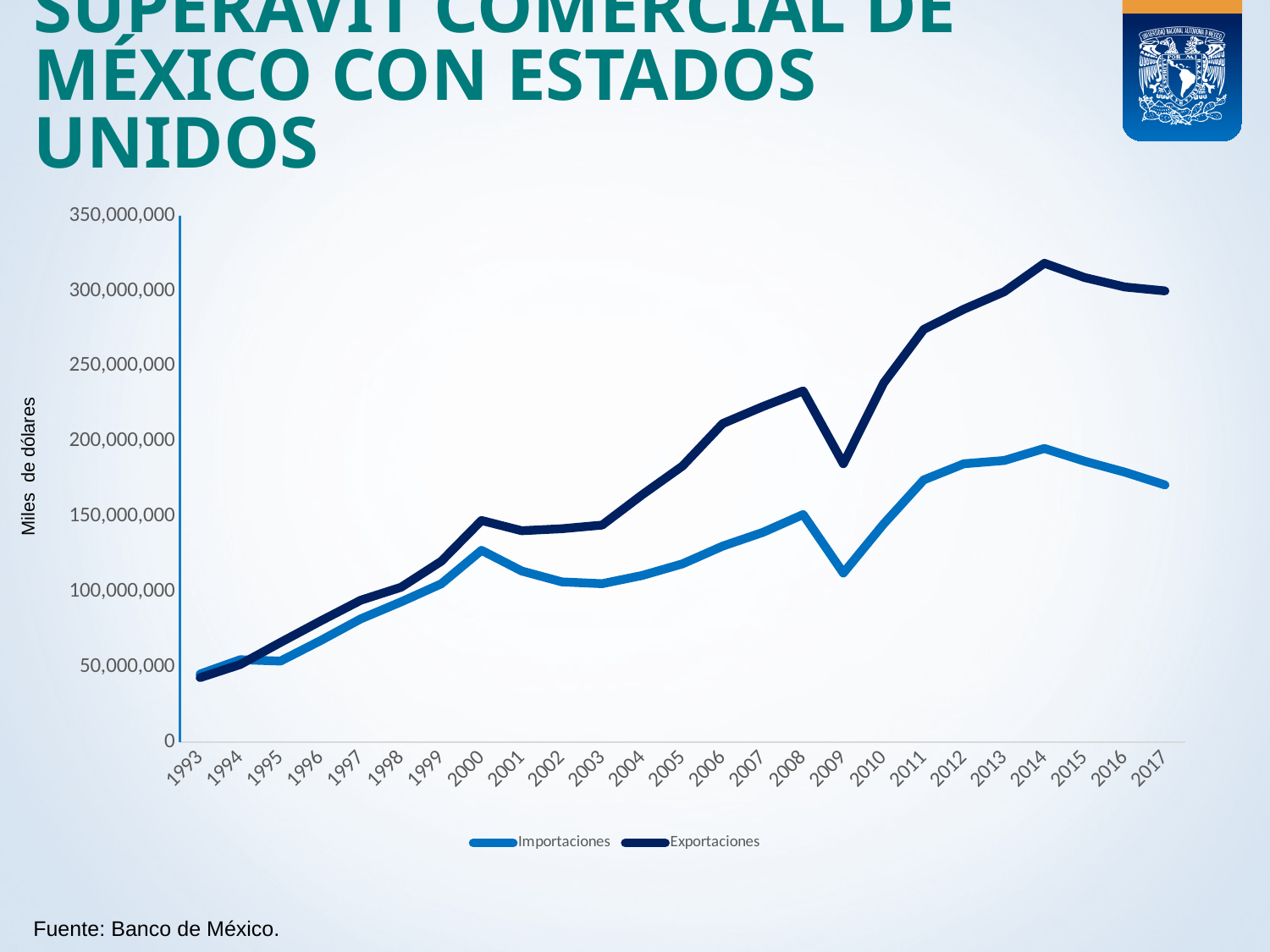
Is the value of Importaciones in 2017 greater or less than 200,000,000? less How many years are shown on the x axis? 25 In which year does the Exportaciones series reach its highest value? 2014 Is the value of Exportaciones in 2009 greater or less than 200,000,000? less Is the value of Exportaciones in 2008 greater or less than 200,000,000? greater In which year does the Importaciones series reach its highest value? 2014 What is the label on the vertical axis? Miles de dólares Which series has the larger value in 2017, Importaciones or Exportaciones? Exportaciones What kind of chart is shown on the slide? line chart In which year is the Exportaciones series at its lowest value? 1993 How many series does the legend list? 2